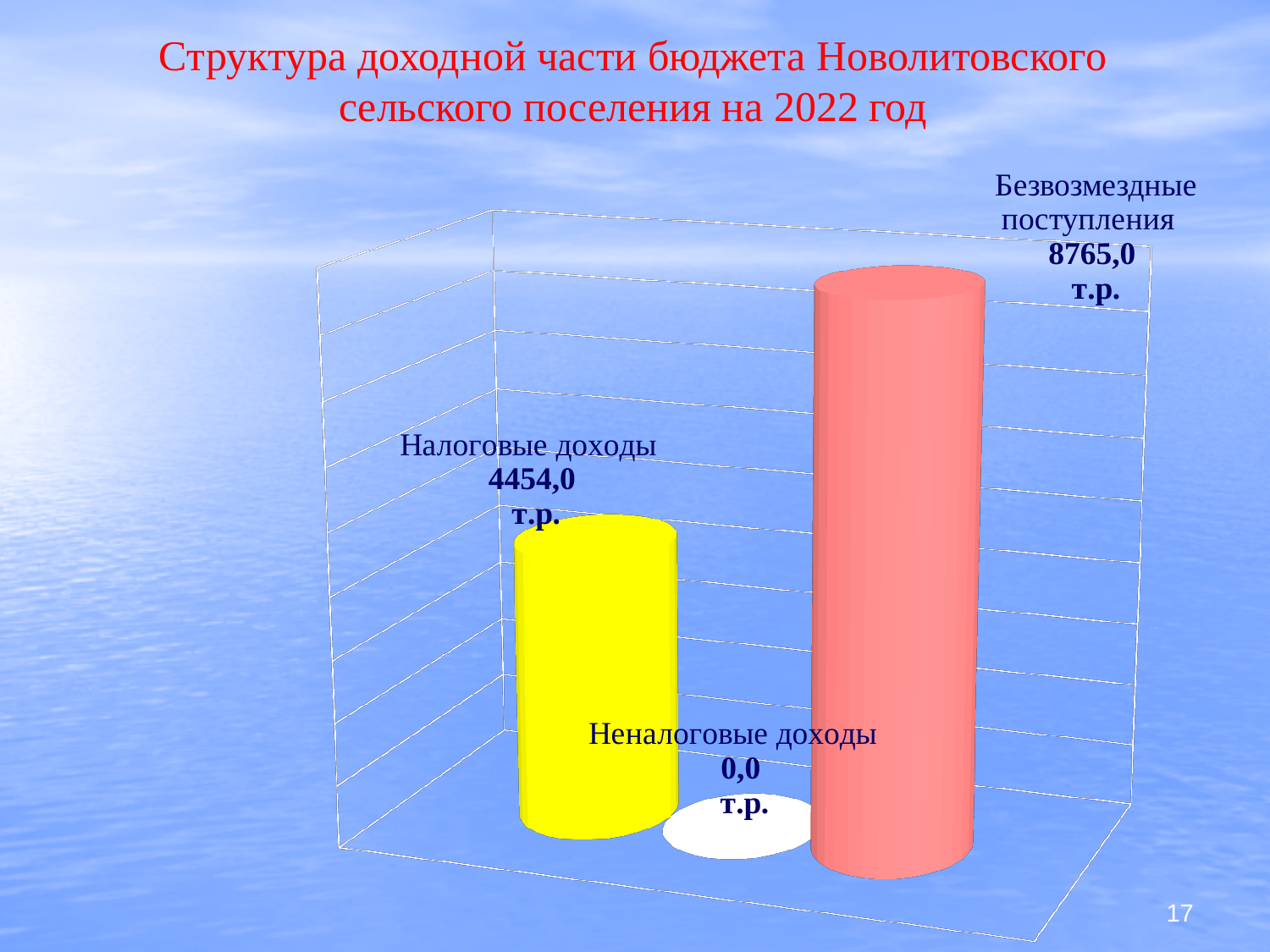
What is the total of all three categories shown in the chart? 13219,0 т.р. Which category has the lowest value? Неналоговые доходы What is the title of the slide? Структура доходной части бюджета Новолитовского сельского поселения на 2022 год What kind of chart is shown on the slide? Bar chart How many categories are shown in the chart? 3 What colour is the bar for Налоговые доходы? Yellow What is the value for Неналоговые доходы? 0,0 т.р. Which category has the highest value? Безвозмездные поступления What is the value for Налоговые доходы? 4454,0 т.р. What is the value for Безвозмездные поступления? 8765,0 т.р. Which is larger, Налоговые доходы or Безвозмездные поступления? Безвозмездные поступления What is the difference between Безвозмездные поступления and Налоговые доходы? 4311,0 т.р.